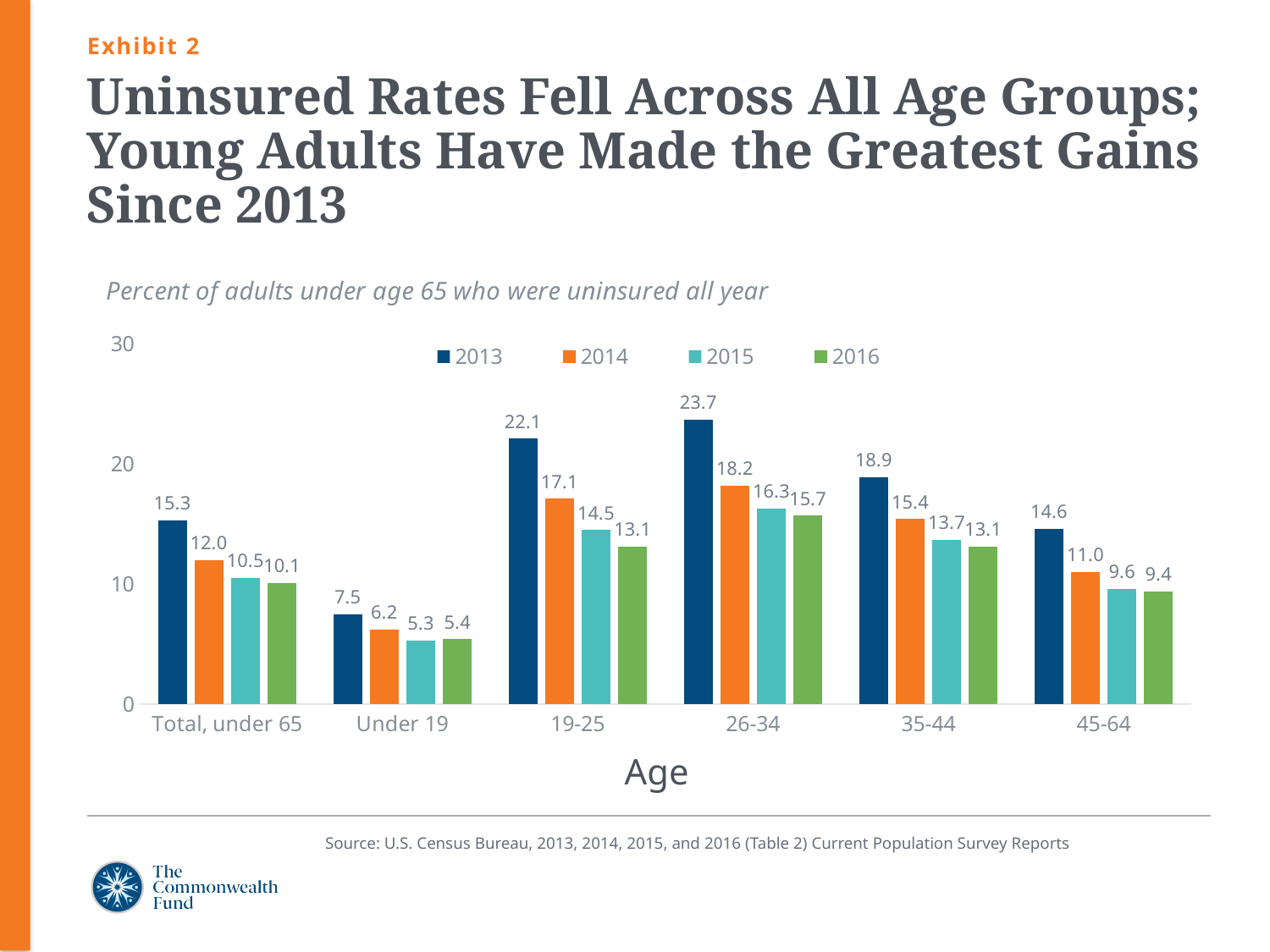
By how many percentage points did the uninsured rate for the 26-34 age group fall from 2013 to 2016? 8.0 Which was higher in 2014: the uninsured rate for Total, under 65 or for 45-64? Total, under 65 Which was higher in 2016: the uninsured rate for 19-25 or for 35-44? They are equal (13.1) How many series does the legend list? 4 Which age group had the lowest uninsured rate in 2015? Under 19 Which age group had the highest uninsured rate in 2013? 26-34 Did the uninsured rate for the 35-44 age group rise or fall from 2013 to 2016? Fall How many age groups are shown on the x axis? 6 What was the uninsured rate for the 19-25 age group in 2013? 22.1 What kind of chart is shown on the slide? Bar chart What was the uninsured rate for the 45-64 age group in 2014? 11.0 What was the uninsured rate for the Under 19 age group in 2016? 5.4